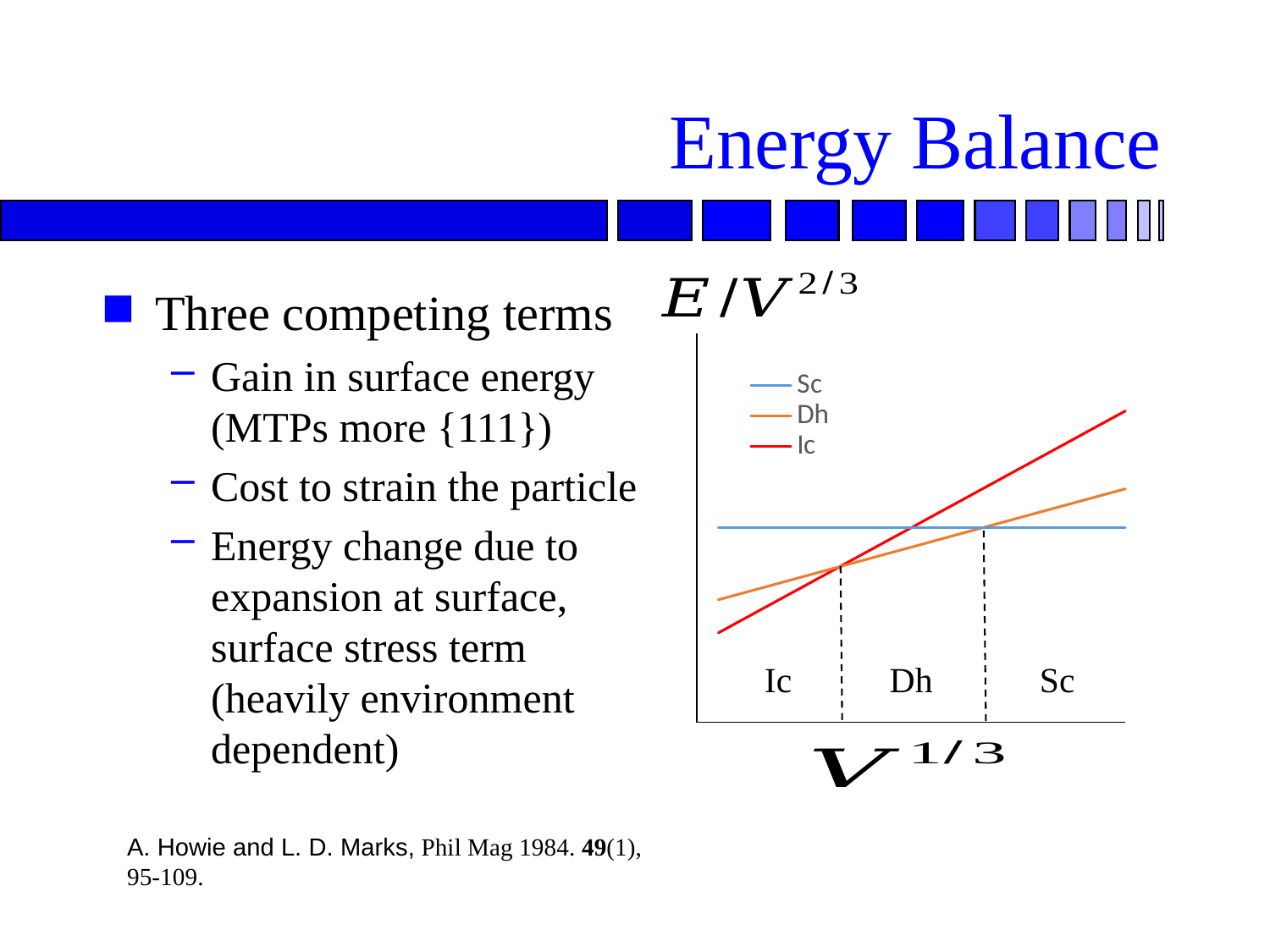
Does the Sc line rise, fall, or stay flat as V^1/3 increases? stays flat At the right end of the chart, which series has the highest E/V^2/3 value? Ic How many series does the chart's legend list? 3 At the right end of the chart, which is larger: the Dh line or the Sc line? Dh At the left end of the chart, which series has the lowest E/V^2/3 value? Ic Which series rises more steeply, Ic or Dh? Ic Which series are listed in the chart's legend? Sc, Dh, Ic Does the Dh line rise or fall as V^1/3 increases? rises What kind of chart is shown on the slide? line chart What label is on the chart's horizontal axis? V^1/3 At the left end of the chart, which is larger: the Sc line or the Dh line? Sc Does the Ic line rise or fall as V^1/3 increases? rises